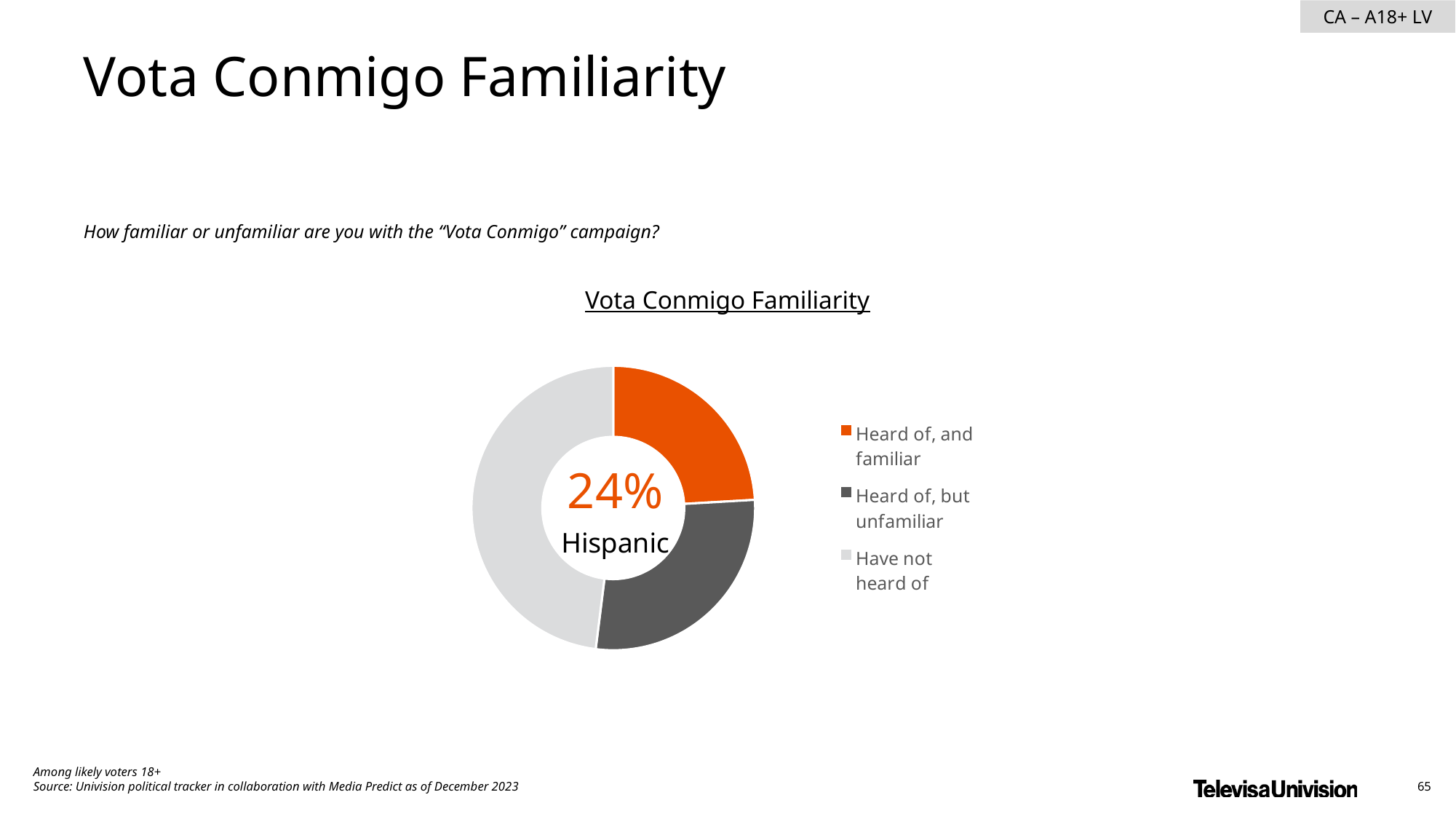
What share of Hispanic likely voters have heard of, and are familiar with, the Vota Conmigo campaign? 24% Which slice is larger: "Have not heard of" or "Heard of, but unfamiliar"? Have not heard of Which group does the label inside the donut chart refer to? Hispanic Which legend category is shown in orange? Heard of, and familiar How many categories does the chart's legend list? 3 Which category has the largest slice in the chart? Have not heard of What percentage is printed in the center of the donut chart? 24% How many slices does the donut chart have? 3 Which slice is larger: "Have not heard of" or "Heard of, and familiar"? Have not heard of What kind of chart is shown on the slide? Pie chart (donut) What is the title of the chart? Vota Conmigo Familiarity